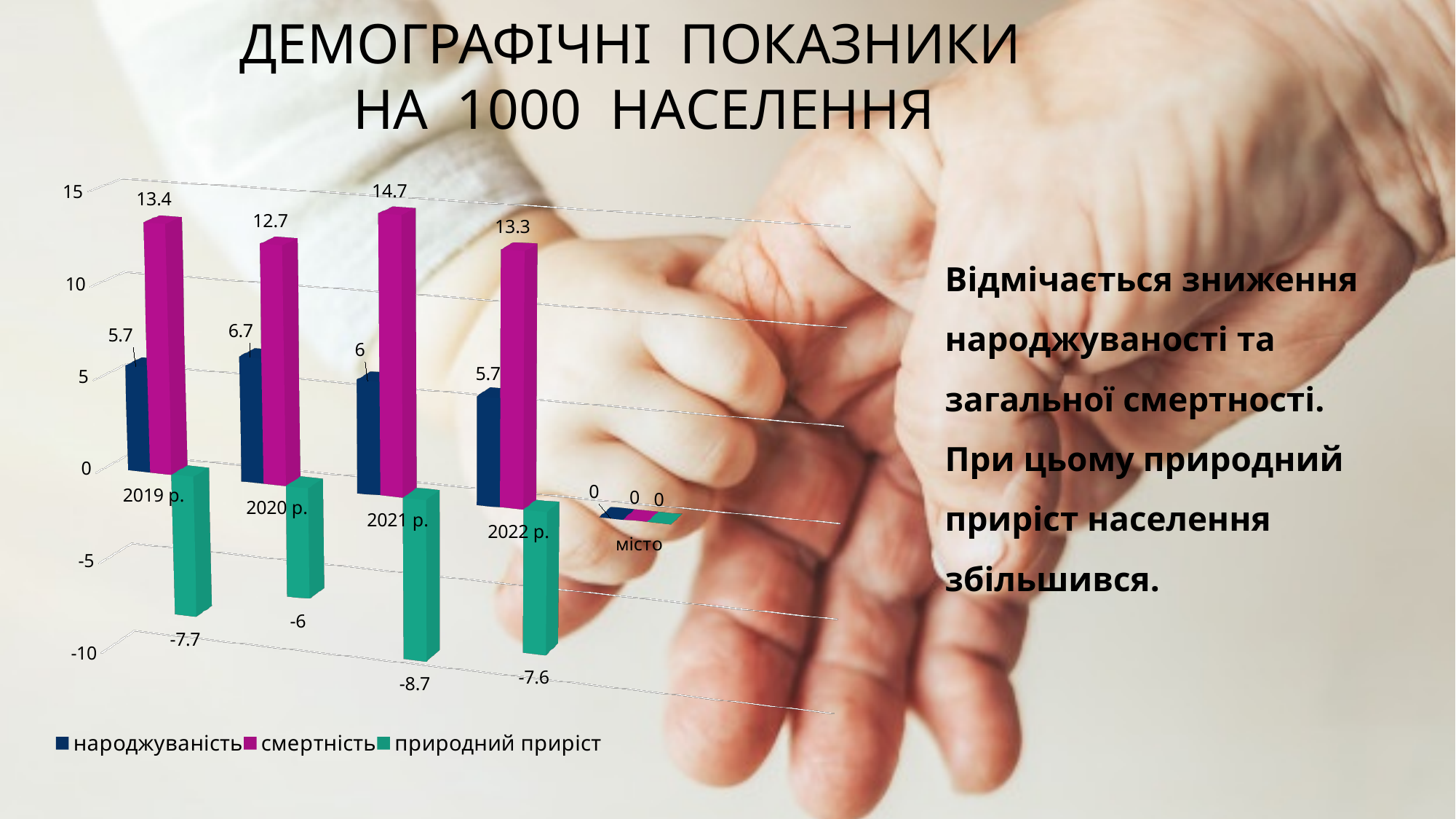
How many series does the legend list? 3 Which is larger: смертність in 2019 р. or смертність in 2020 р.? смертність in 2019 р. What is the value of смертність for 2022 р.? 13.3 In which year is народжуваність highest? 2020 р. What kind of chart is shown on the slide? bar chart What is the difference between смертність and народжуваність in 2021 р.? 8.7 What is the value of природний приріст for 2020 р.? -6 Which series is shown in magenta in the legend? смертність What is the value of народжуваність for 2020 р.? 6.7 What is the value of природний приріст for 2021 р.? -8.7 What is the value of смертність for 2019 р.? 13.4 In which year is смертність highest? 2021 р.